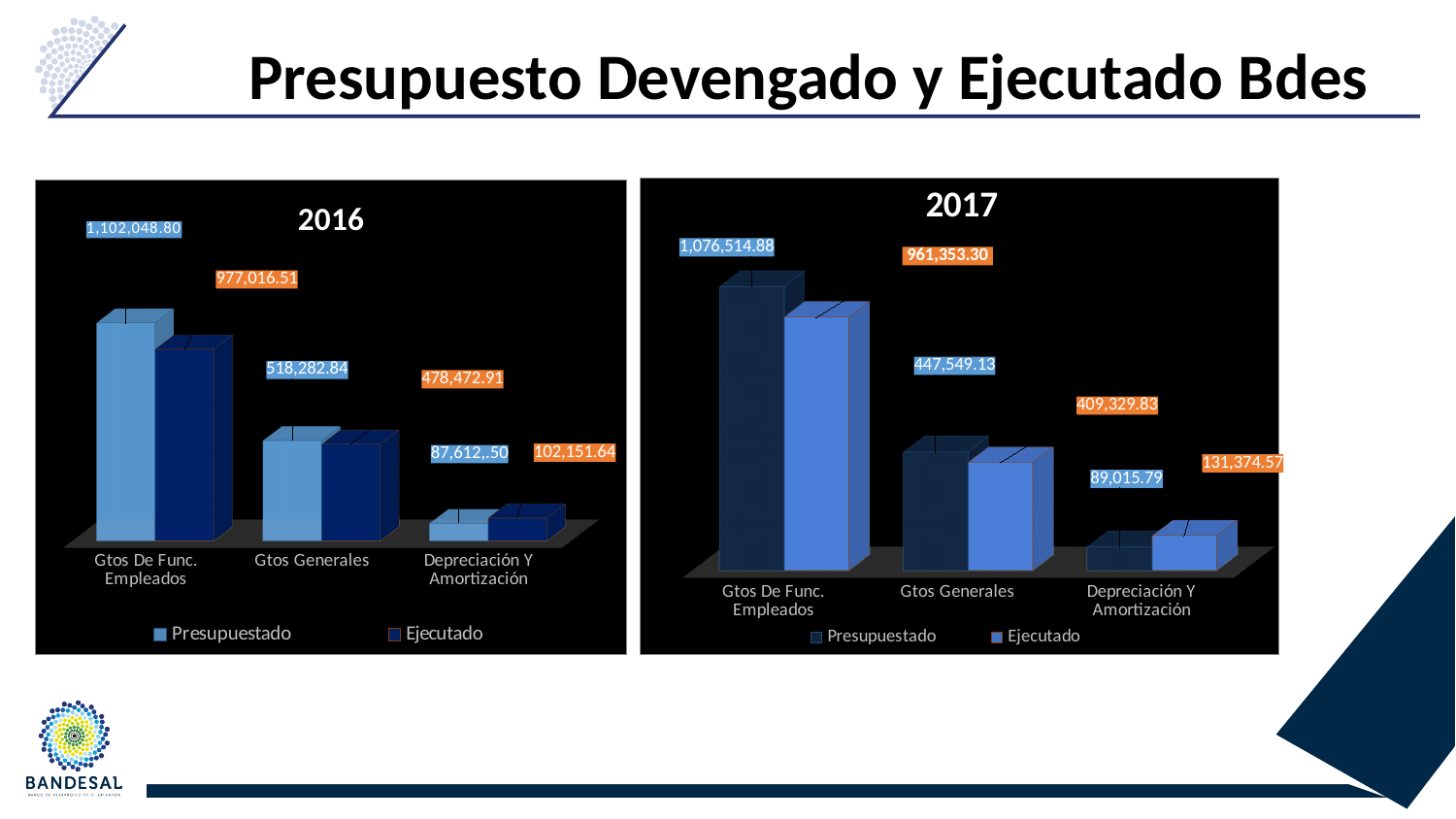
How many series does the legend of the 2017 chart list? 2 In the 2017 chart, what is the Ejecutado value for Gtos De Func. Empleados? 961,353.30 In the 2016 chart, what is the Presupuestado value for Gtos De Func. Empleados? 1,102,048.80 In the 2017 chart, what is the difference between the Presupuestado and Ejecutado values for Gtos Generales? 38,219.30 In the 2016 chart, what is the Ejecutado value for Depreciación Y Amortización? 102,151.64 In the 2017 chart, what is the Ejecutado value for Depreciación Y Amortización? 131,374.57 In the 2017 chart, what is the Presupuestado value for Gtos Generales? 447,549.13 In the 2017 chart, which is larger for Depreciación Y Amortización, Presupuestado or Ejecutado? Ejecutado In the 2017 chart, which category has the lowest Ejecutado value? Depreciación Y Amortización In the 2016 chart, what is the difference between the Presupuestado and Ejecutado values for Gtos De Func. Empleados? 125,032.29 In the 2016 chart, what is the Ejecutado value for Gtos Generales? 478,472.91 In the 2016 chart, which category has the highest Presupuestado value? Gtos De Func. Empleados